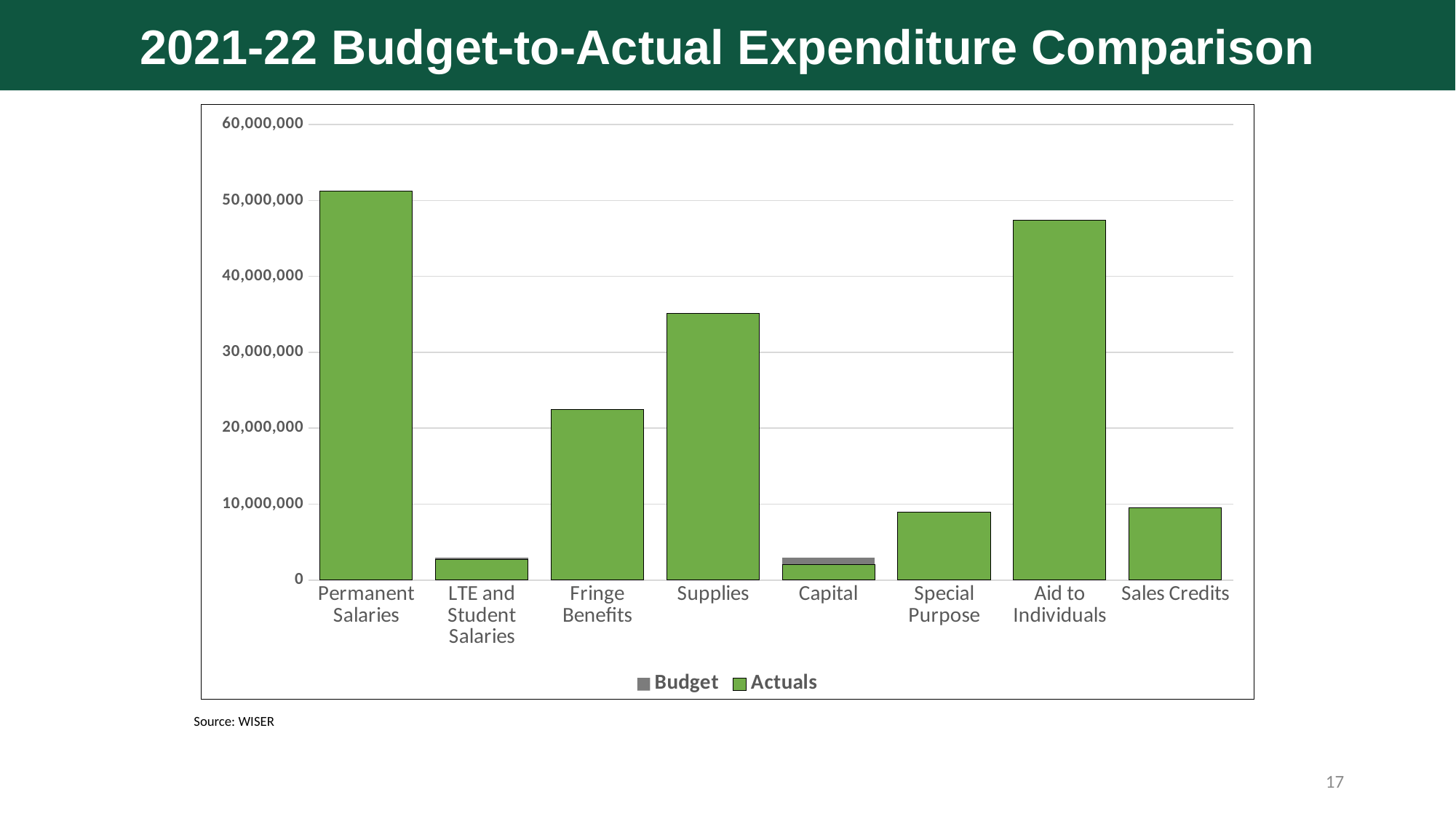
How many expenditure categories are shown on the x axis? 8 How many series does the legend list? 2 Which has the larger Actuals value, Supplies or Fringe Benefits? Supplies Which has the larger Actuals value, Aid to Individuals or Supplies? Aid to Individuals Is the Actuals value for Permanent Salaries greater or less than 40,000,000? greater Is the Actuals value for Aid to Individuals greater or less than 50,000,000? less Is the Actuals value for Fringe Benefits greater or less than 20,000,000? greater What kind of chart is shown on the slide? bar chart Which category has the highest Actuals value? Permanent Salaries What is the title of the slide containing the chart? 2021-22 Budget-to-Actual Expenditure Comparison